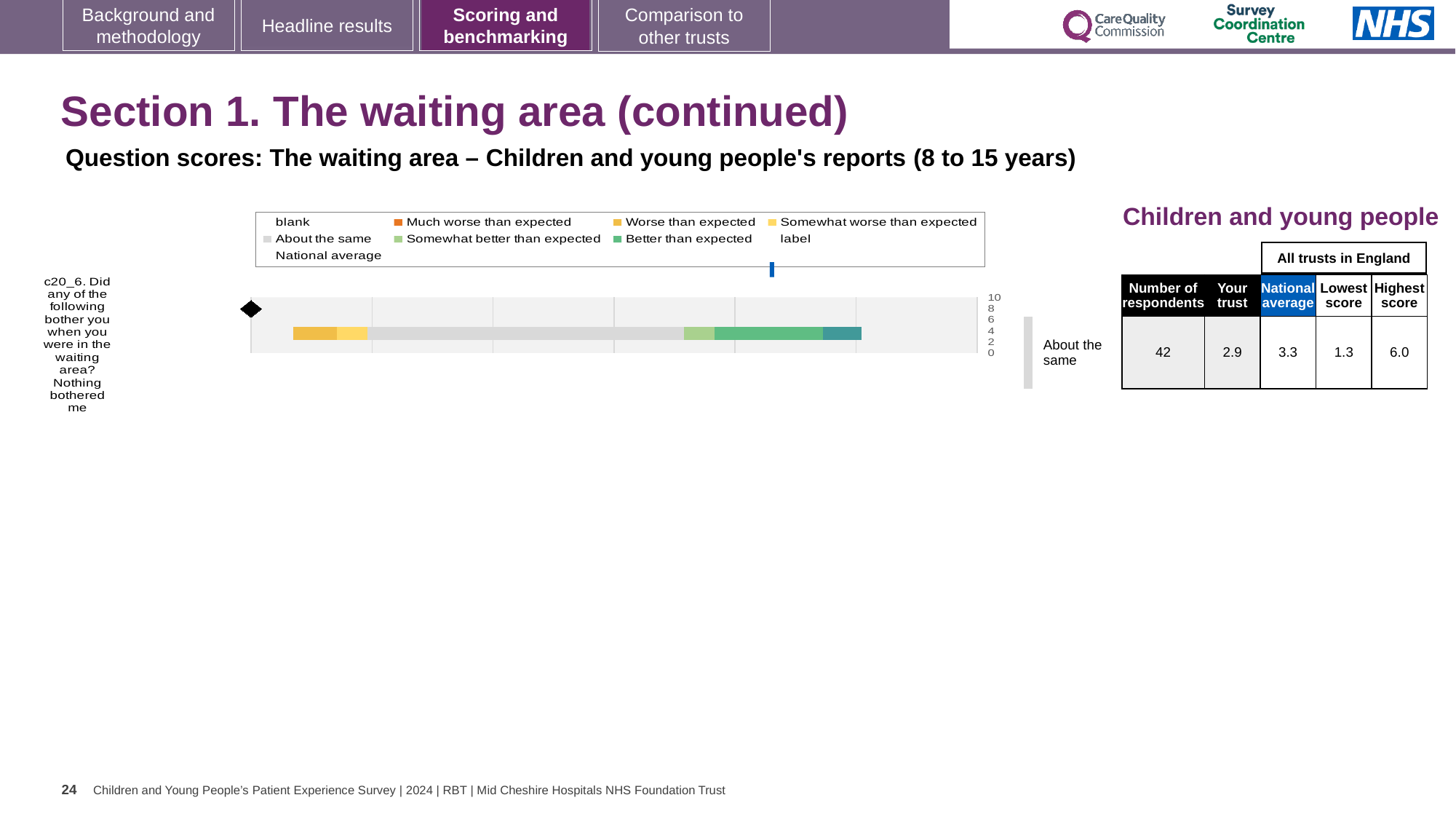
Which is larger for question c20_6: the trust's score or the national average? National average What is the lowest score among all trusts in England for question c20_6? 1.3 Which legend entry is shown with a dark orange colour in the chart legend? Much worse than expected Which benchmark category is the trust's result for c20_6 placed in, as labelled to the right of the bar? About the same What is the 'Your trust' score for question c20_6 in the Children and young people table? 2.9 What is the difference between the national average (3.3) and the trust's score (2.9) for question c20_6? 0.4 How many respondents answered question c20_6 for the trust? 42 What is the difference between the highest score (6.0) and the lowest score (1.3) for question c20_6? 4.7 What is the highest score among all trusts in England for question c20_6? 6.0 What is the national average score for question c20_6? 3.3 What kind of chart is used to show the benchmarking result for question c20_6? bar chart How many questions are plotted in the benchmarking chart on this slide? 1